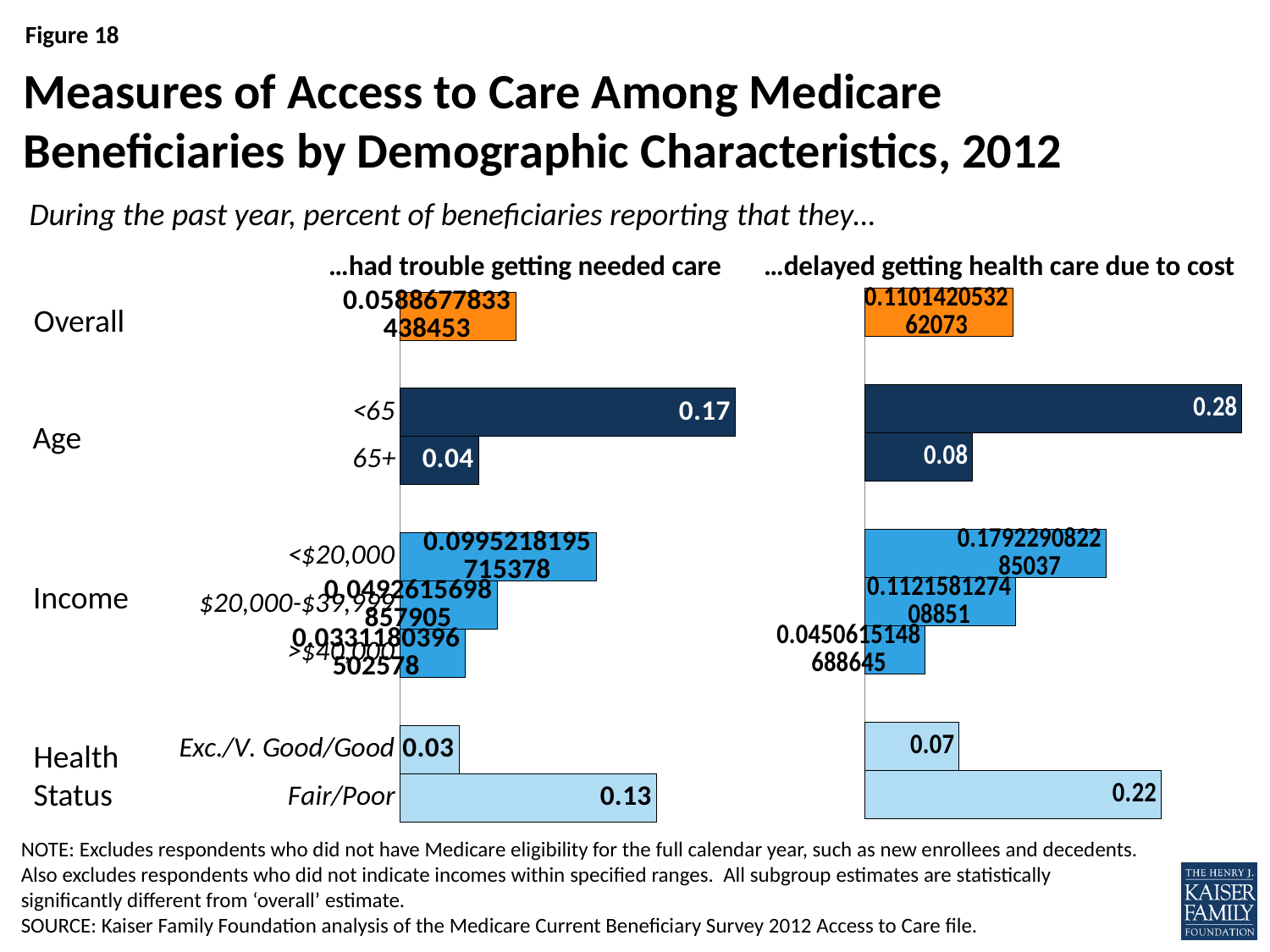
In the '...had trouble getting needed care' chart, what is the value for beneficiaries aged 65+? 0.04 In the '...delayed getting health care due to cost' chart, which category has the highest value? <65 In the '...had trouble getting needed care' chart, which category has the highest value? <65 In the '...delayed getting health care due to cost' chart, what is the value for beneficiaries under 65 (<65)? 0.28 In the '...delayed getting health care due to cost' chart, what is the difference between the Fair/Poor and Exc./V. Good/Good values? 0.15 How many bars are plotted in the '...had trouble getting needed care' chart? 8 What kind of chart is used on this slide? bar chart In the '...delayed getting health care due to cost' chart, what is the value for Fair/Poor health status? 0.22 In the '...had trouble getting needed care' chart, what is the value for beneficiaries under 65 (<65)? 0.17 In the '...delayed getting health care due to cost' chart, which is larger: the value for <65 or the value for Fair/Poor? <65 In the '...had trouble getting needed care' chart, what is the value for Exc./V. Good/Good health status? 0.03 In the '...had trouble getting needed care' chart, what is the difference between the <65 and 65+ values? 0.13